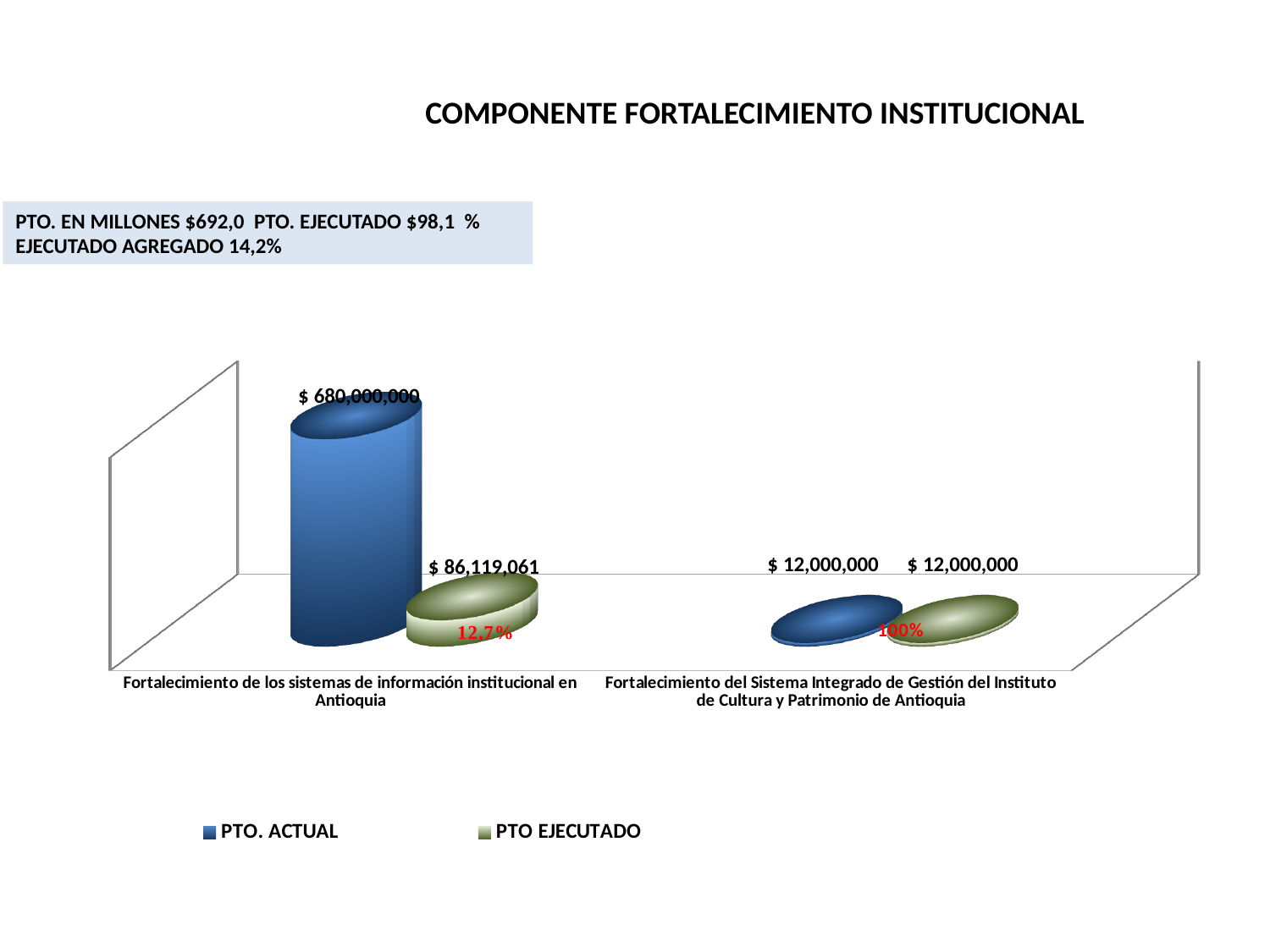
How many series does the chart legend list? 2 What is the PTO. ACTUAL value for "Fortalecimiento del Sistema Integrado de Gestión del Instituto de Cultura y Patrimonio de Antioquia"? $ 12,000,000 What is the difference between PTO. ACTUAL and PTO EJECUTADO for "Fortalecimiento de los sistemas de información institucional en Antioquia"? $ 593,880,939 What execution percentage is shown in red for "Fortalecimiento del Sistema Integrado de Gestión del Instituto de Cultura y Patrimonio de Antioquia"? 100% What is the PTO EJECUTADO value for "Fortalecimiento del Sistema Integrado de Gestión del Instituto de Cultura y Patrimonio de Antioquia"? $ 12,000,000 What is the PTO EJECUTADO value for "Fortalecimiento de los sistemas de información institucional en Antioquia"? $ 86,119,061 Which is larger for "Fortalecimiento de los sistemas de información institucional en Antioquia": PTO. ACTUAL or PTO EJECUTADO? PTO. ACTUAL What kind of chart is shown on the slide? Bar chart What is the PTO. ACTUAL value for "Fortalecimiento de los sistemas de información institucional en Antioquia"? $ 680,000,000 How many categories are shown on the x axis of the chart? 2 Which category has the lowest PTO EJECUTADO value? Fortalecimiento del Sistema Integrado de Gestión del Instituto de Cultura y Patrimonio de Antioquia Which category has the highest PTO. ACTUAL value? Fortalecimiento de los sistemas de información institucional en Antioquia